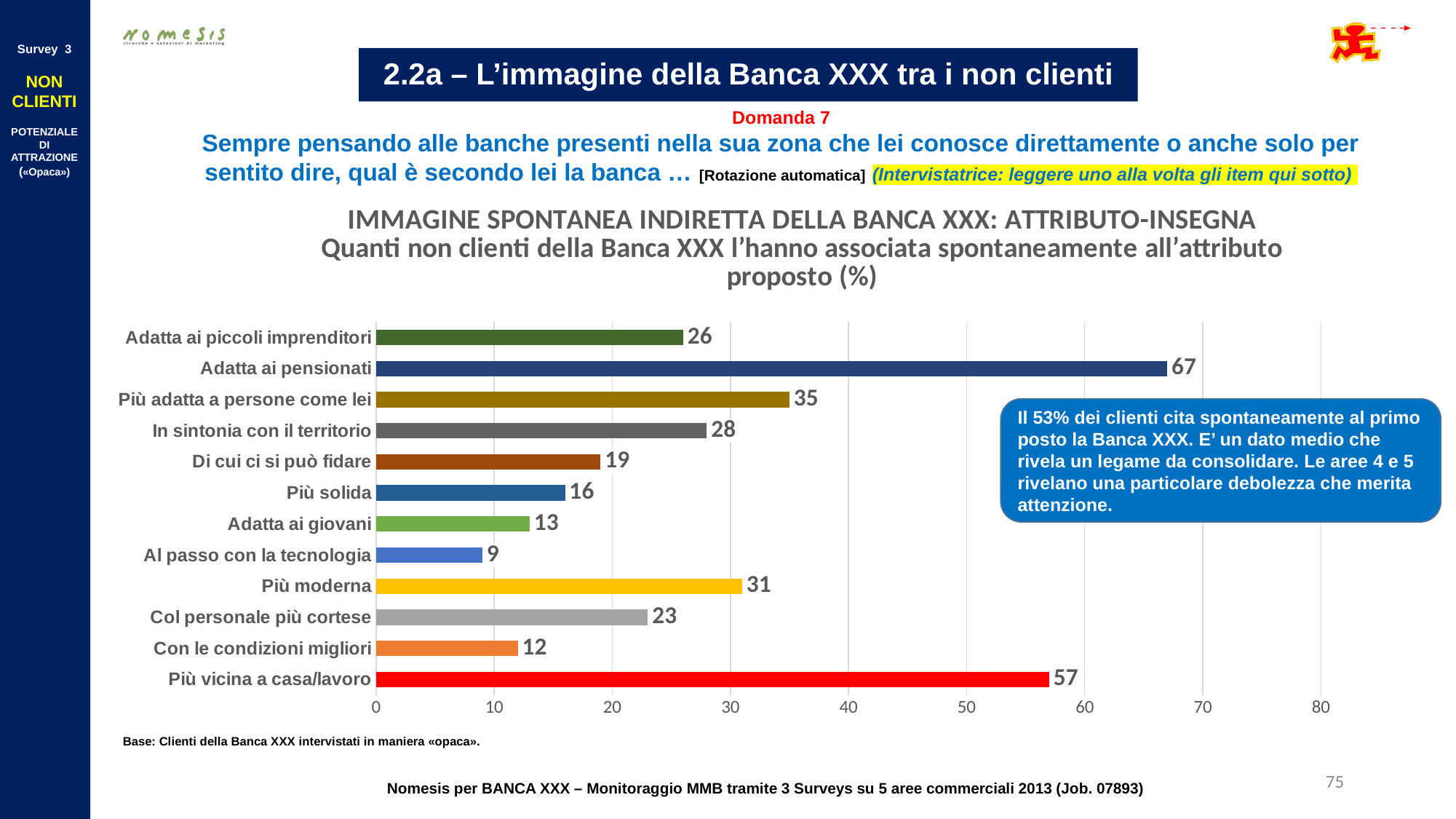
What is the difference between "Adatta ai piccoli imprenditori" and "Adatta ai giovani"? 13 What is the value for "Al passo con la tecnologia"? 9 What is the difference between "Adatta ai pensionati" and "Più vicina a casa/lavoro"? 10 What is the value for "Più vicina a casa/lavoro"? 57 Which is larger, "Più adatta a persone come lei" or "In sintonia con il territorio"? Più adatta a persone come lei Which category has the highest value? Adatta ai pensionati What is the value for "Adatta ai pensionati"? 67 What kind of chart is shown on the slide? Bar chart Is the value for "Col personale più cortese" greater or less than 20? greater What is the value for "Più moderna"? 31 How many categories are shown in the chart? 12 Which category has the lowest value? Al passo con la tecnologia